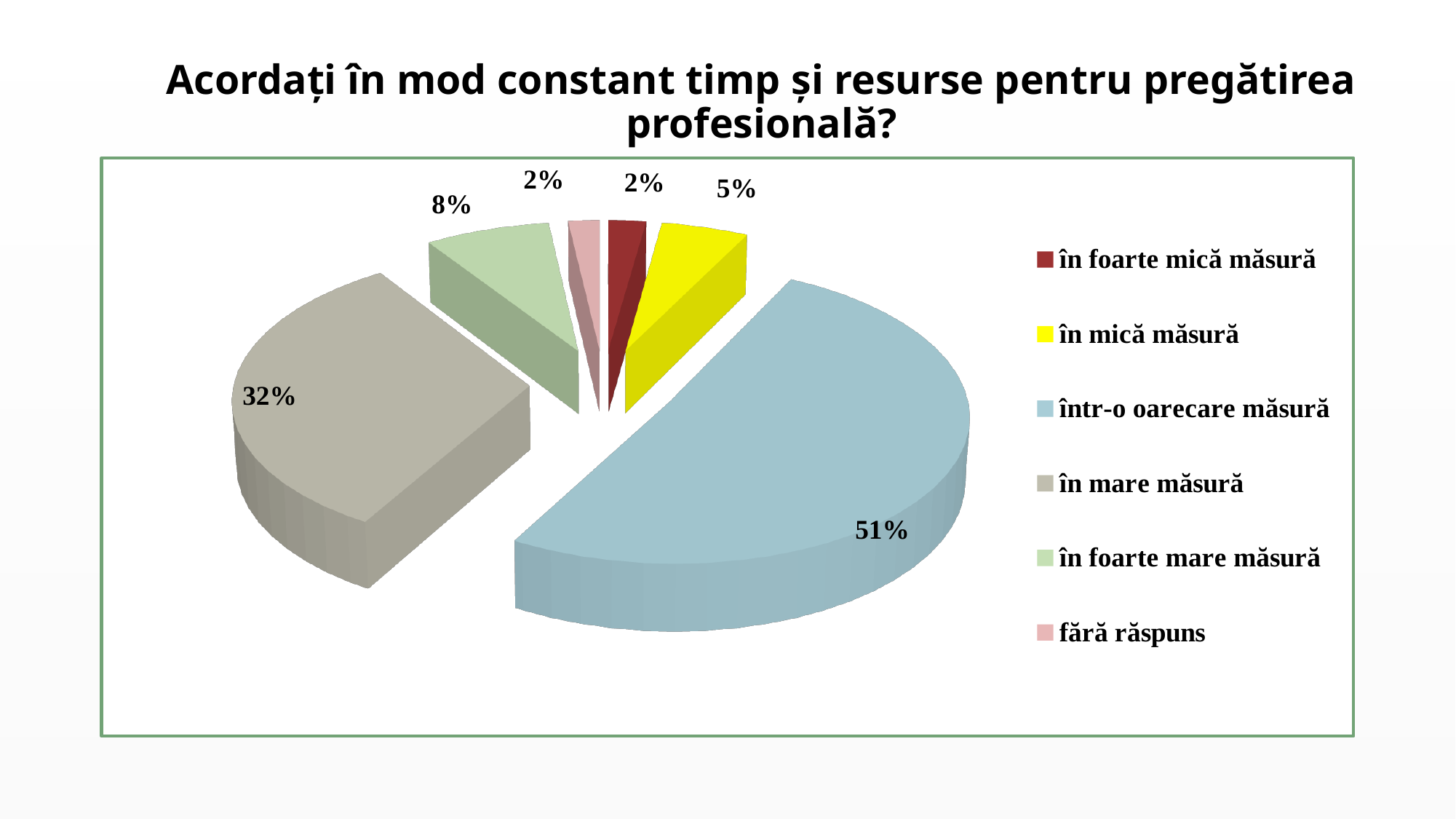
Which colour represents "în mică măsură" in the pie chart? yellow What percentage of respondents answered "în mică măsură"? 5% What kind of chart is shown on the slide? pie chart What percentage of respondents answered "în foarte mare măsură"? 8% Which response category has the largest share of the pie? într-o oarecare măsură What is the title of the chart on the slide? Acordați în mod constant timp și resurse pentru pregătirea profesională? Which is larger, the share for "în foarte mare măsură" or the share for "în mică măsură"? în foarte mare măsură What percentage of respondents answered "în mare măsură"? 32% How many categories does the legend list? 6 What percentage of respondents answered "într-o oarecare măsură"? 51% What is the difference in percentage points between "într-o oarecare măsură" and "în mare măsură"? 19 What percentage of respondents gave no answer ("fără răspuns")? 2%